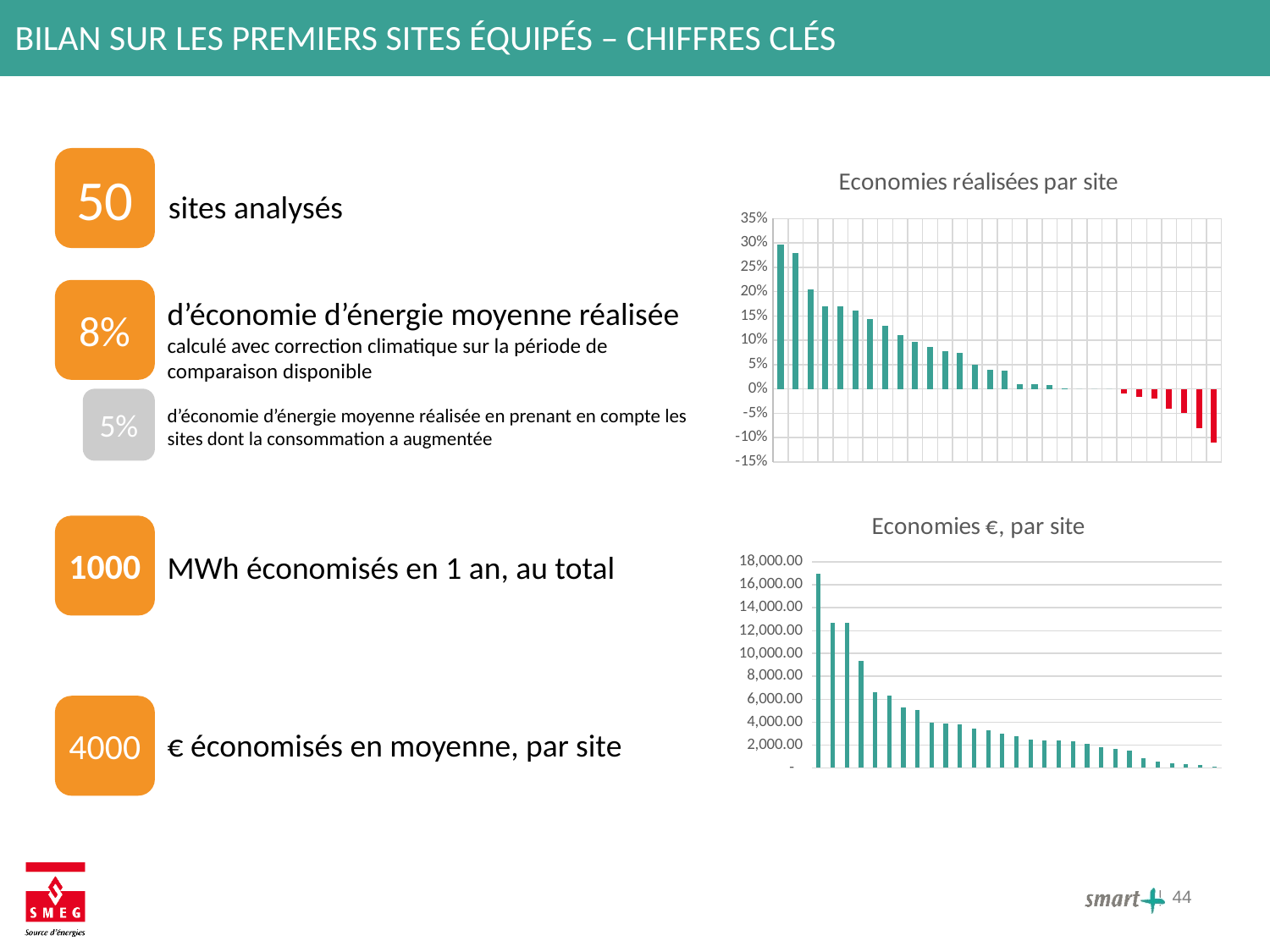
In the chart "Economies réalisées par site", is the value of the rightmost bar greater or less than -5%? less In the chart "Economies €, par site", which is larger, the leftmost bar or the second bar from the left? the leftmost bar In the chart "Economies réalisées par site", what colour are the bars with negative values? red In the chart "Economies €, par site", is the value of the second bar from the left greater or less than 14,000.00? less What kind of chart is "Economies réalisées par site"? bar chart In the chart "Economies réalisées par site", which is larger, the leftmost bar or the third bar from the left? the leftmost bar What kind of chart is "Economies €, par site"? bar chart In the chart "Economies réalisées par site", do the values rise or fall from left to right? fall What is the title of the upper chart on the slide? Economies réalisées par site In the chart "Economies €, par site", do the values rise or fall from left to right? fall In the chart "Economies réalisées par site", is the value of the leftmost bar greater or less than 25%? greater